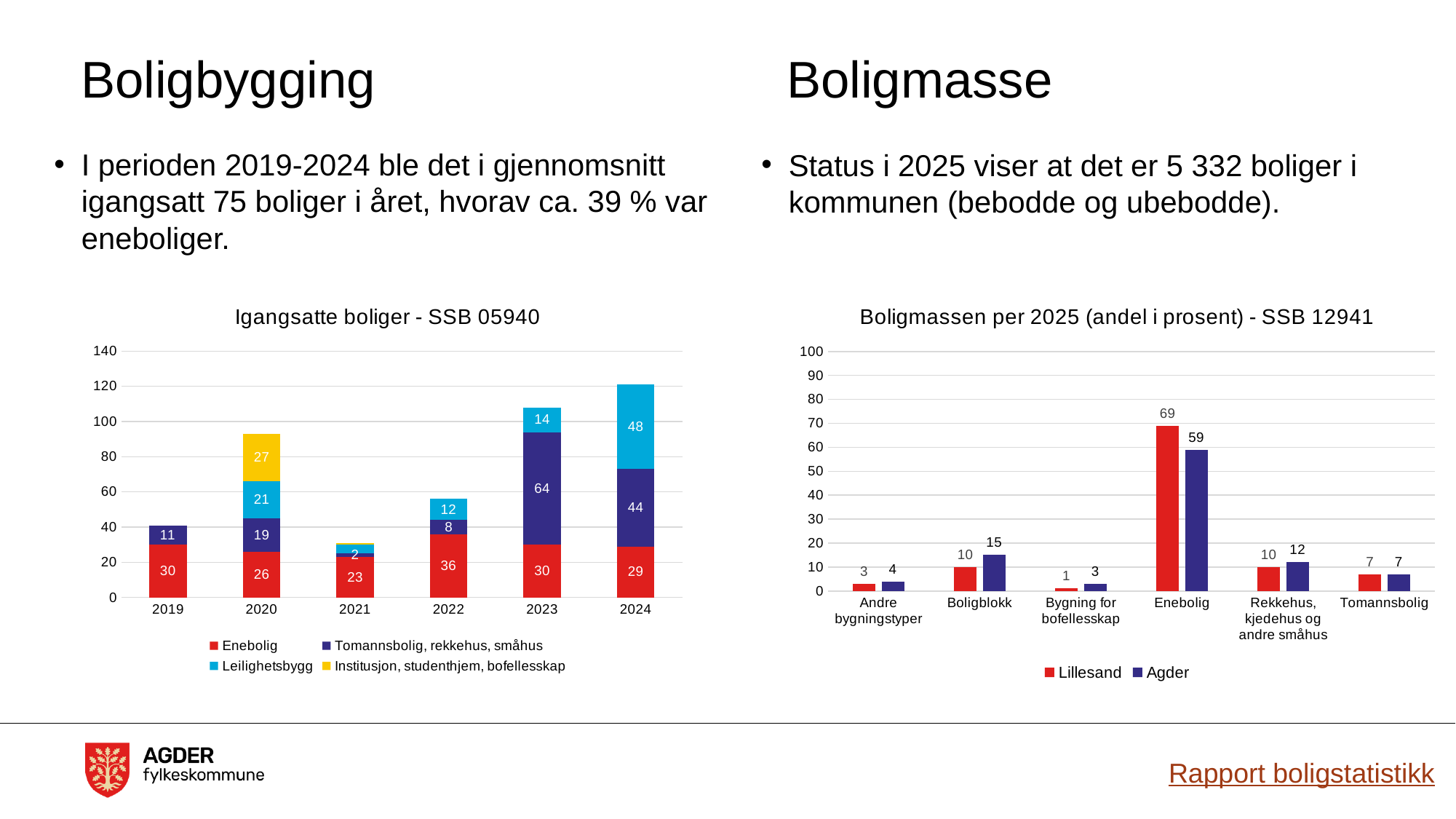
What kind of chart is 'Boligmassen per 2025 (andel i prosent) - SSB 12941'? Bar chart In the chart 'Igangsatte boliger - SSB 05940', what is the value for Enebolig in 2022? 36 In the chart 'Igangsatte boliger - SSB 05940', what is the total of the stacked bar for 2023? 108 In the chart 'Igangsatte boliger - SSB 05940', what is the value for Leilighetsbygg in 2024? 48 In the chart 'Boligmassen per 2025 (andel i prosent) - SSB 12941', how many categories are shown on the x axis? 6 In the chart 'Boligmassen per 2025 (andel i prosent) - SSB 12941', which category has the highest value for Agder? Enebolig In the chart 'Igangsatte boliger - SSB 05940', which year has the lowest total stacked bar? 2021 In the chart 'Boligmassen per 2025 (andel i prosent) - SSB 12941', what is the difference between Agder and Lillesand for Boligblokk? 5 In the chart 'Igangsatte boliger - SSB 05940', what is the total of the stacked bar for 2020? 93 In the chart 'Igangsatte boliger - SSB 05940', how many series does the legend list? 4 In the chart 'Boligmassen per 2025 (andel i prosent) - SSB 12941', what is the value for Lillesand for Enebolig? 69